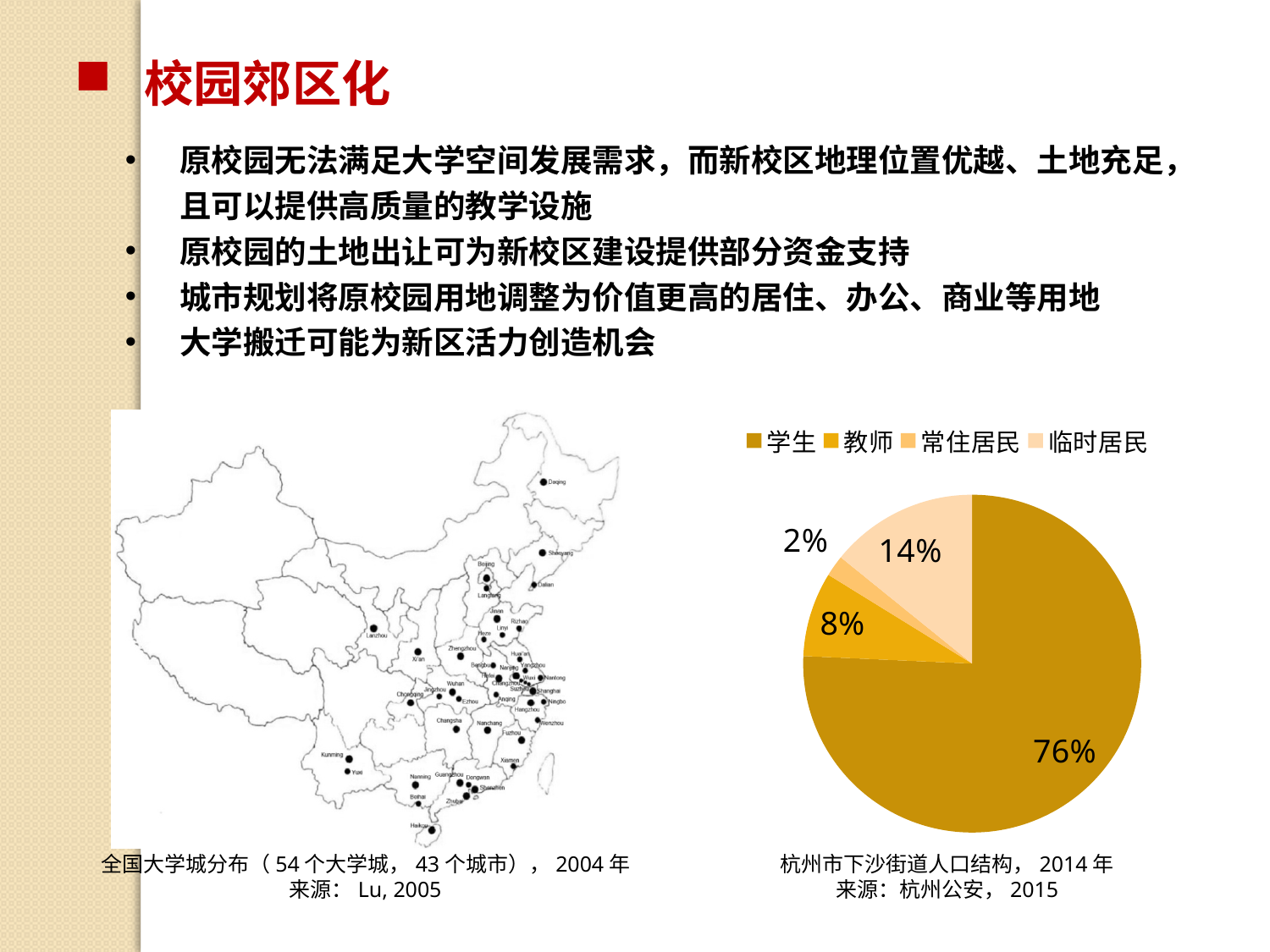
In the pie chart, what share is shown for 学生? 76% In the pie chart, what share is shown for 常住居民? 2% In the pie chart, what share is shown for 教师? 8% How many slices does the pie chart have? 4 What kind of chart is shown on the right side of the slide? pie chart What is the caption title of the pie chart? 杭州市下沙街道人口结构，2014年 In the pie chart, what share is shown for 临时居民? 14% Which category has the largest slice in the pie chart? 学生 Which category has the smallest slice in the pie chart? 常住居民 In the pie chart, what is the difference between the shares of 学生 and 临时居民? 62% How many categories does the legend of the pie chart list? 4 In the pie chart, which is larger: 教师 or 临时居民? 临时居民